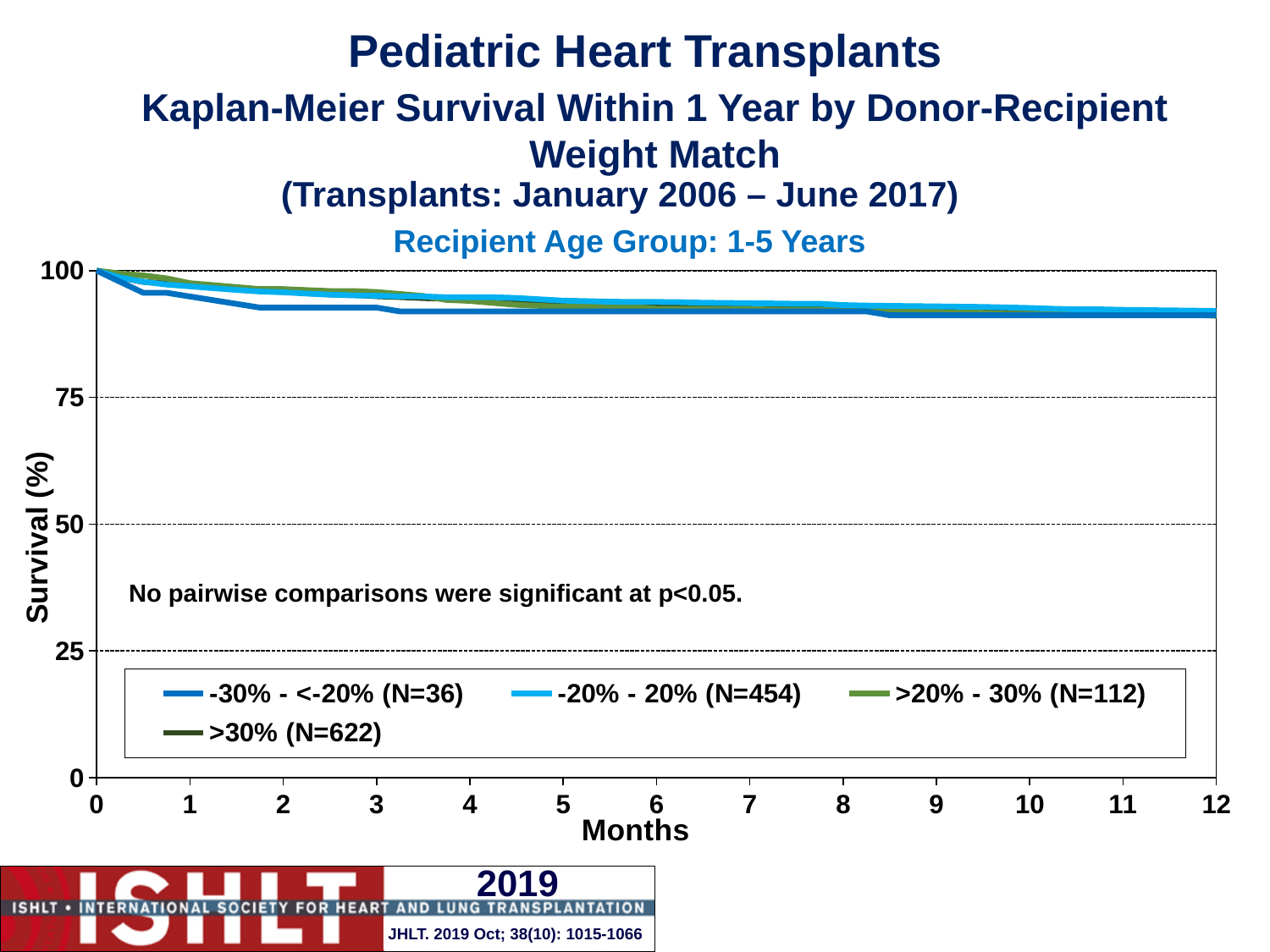
What is the recipient age group shown in the chart subtitle? 1-5 Years What kind of chart is shown on the slide? Line chart Is the survival value for the -30% - <-20% group at 6 months greater or less than 75? greater What is the N for the -20% - 20% weight match group? 454 What is the label of the y axis? Survival (%) How many series does the legend list? 4 Is the survival value for the -20% - 20% group at 12 months greater or less than 75? greater Which weight match group has the smallest N in the legend? -30% - <-20% (N=36) What is the N for the -30% - <-20% weight match group? 36 Which weight match group has the largest N in the legend? >30% (N=622) What is the N for the >30% weight match group? 622 Do the survival curves rise or fall as months increase along the x axis? fall